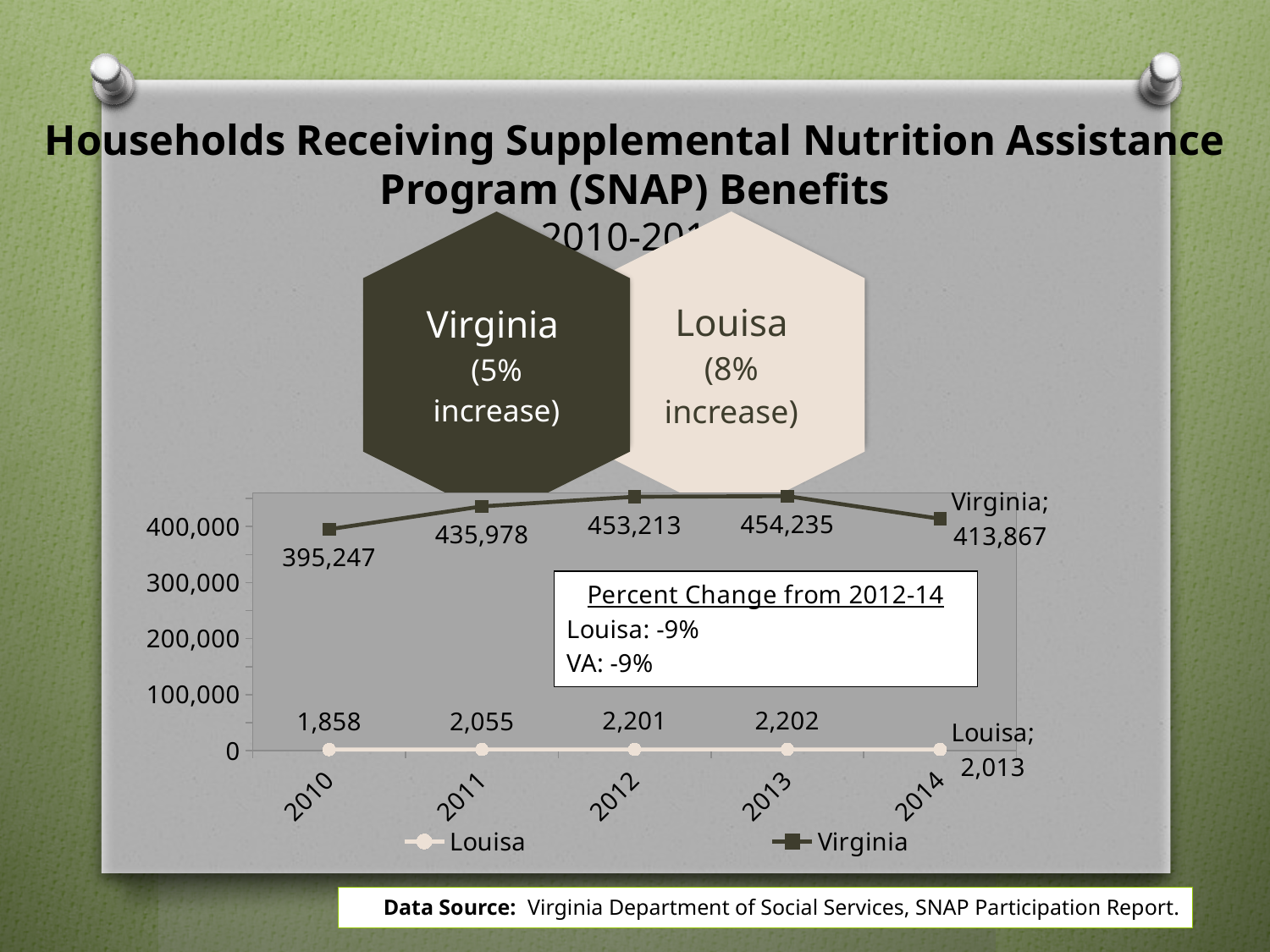
In which year is the Virginia value highest? 2013 In which year is the Louisa value lowest? 2010 What is the value for Virginia in 2014? 413,867 What is the value for Virginia in 2010? 395,247 How many series does the legend list? 2 What kind of chart is shown on the slide? line chart What is the difference between the Virginia values for 2013 and 2014? 40,368 What is the value for Louisa in 2012? 2,201 How many years are plotted along the x axis? 5 Does the Virginia series rise or fall from 2010 to 2013? rise What percent change from 2012-14 does the text box give for Louisa? -9% Which is larger, the Louisa value for 2011 or for 2014? 2011